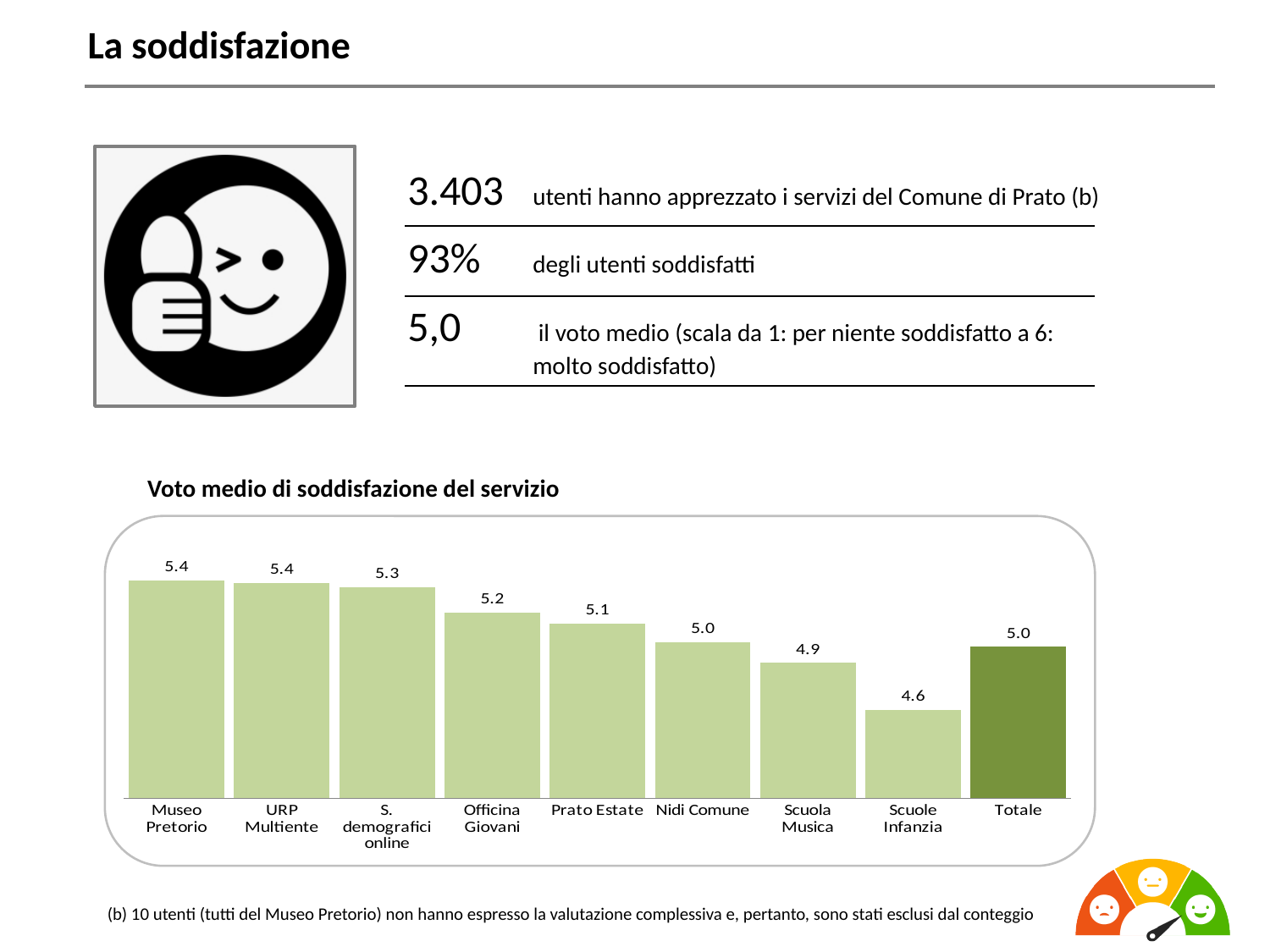
How many bars are shown in the chart? 9 What is the value shown for Totale? 5.0 What kind of chart is shown on the slide? Bar chart What is the difference between the scores for Museo Pretorio and Scuole Infanzia? 0.8 What is the difference between the scores for S. demografici online and Nidi Comune? 0.3 What is the average satisfaction score for Officina Giovani? 5.2 What is the average satisfaction score for Scuola Musica? 4.9 What is the title of the chart? Voto medio di soddisfazione del servizio Do the values rise or fall from Museo Pretorio to Scuole Infanzia along the x axis? Fall What is the average satisfaction score for Scuole Infanzia? 4.6 Which category has the lowest average satisfaction score? Scuole Infanzia Which is higher, the score for Prato Estate or the score for Scuola Musica? Prato Estate